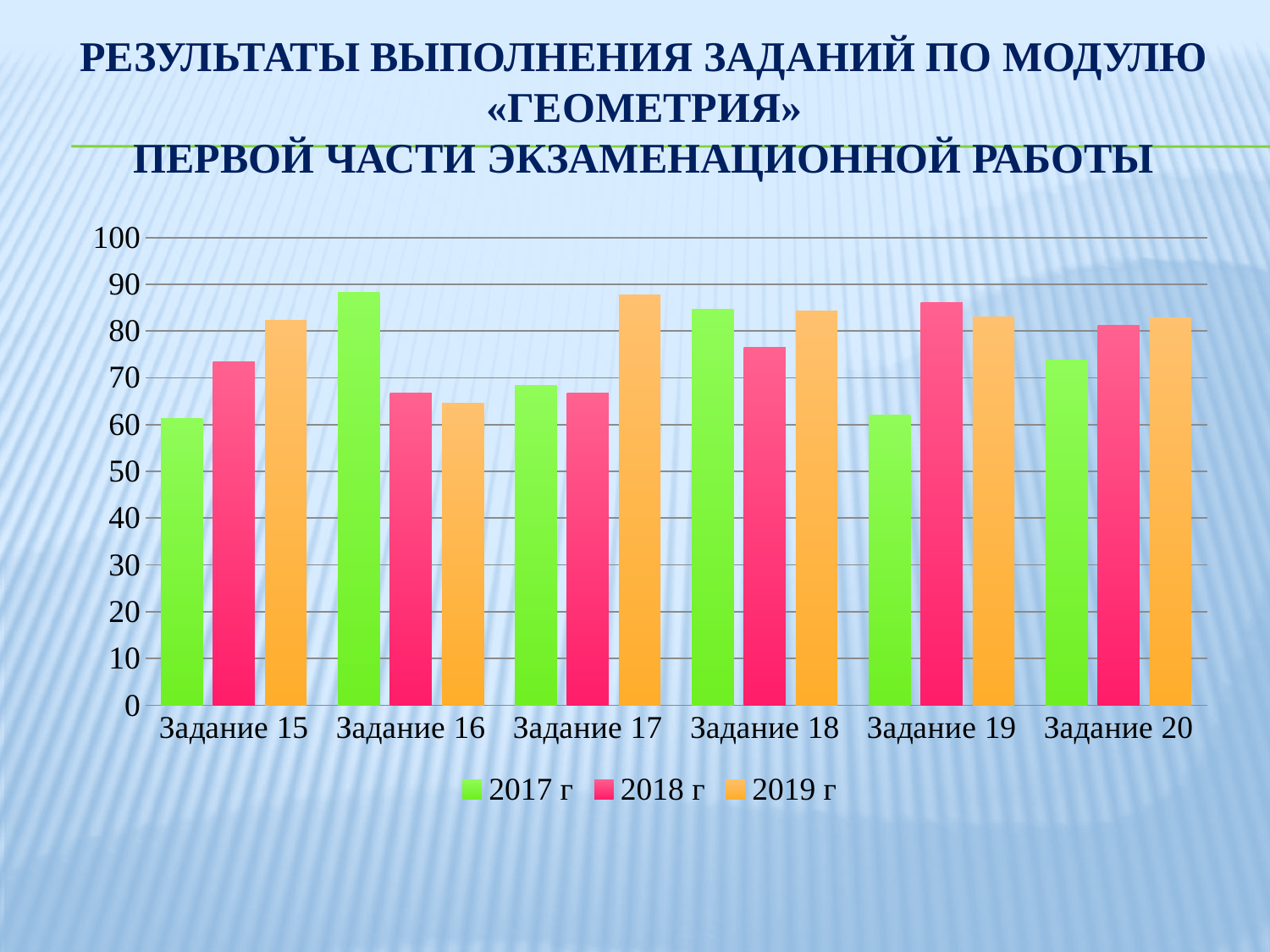
Is the value for 2017 г at Задание 15 greater or less than 70? less How many series does the legend list? 3 What colour represents the 2019 г series in the legend? orange What kind of chart is shown on the slide? bar chart For the 2019 г series, which task has the lowest value? Задание 16 At Задание 19, which is larger: the value for 2017 г or for 2018 г? 2018 г For the 2018 г series, which task has the highest value? Задание 19 Is the value for 2019 г at Задание 17 greater or less than 80? greater Is the value for 2018 г at Задание 18 greater or less than 70? greater How many task categories are shown on the x axis? 6 At Задание 16, which is larger: the value for 2017 г or for 2019 г? 2017 г For the 2017 г series, which task has the highest value? Задание 16